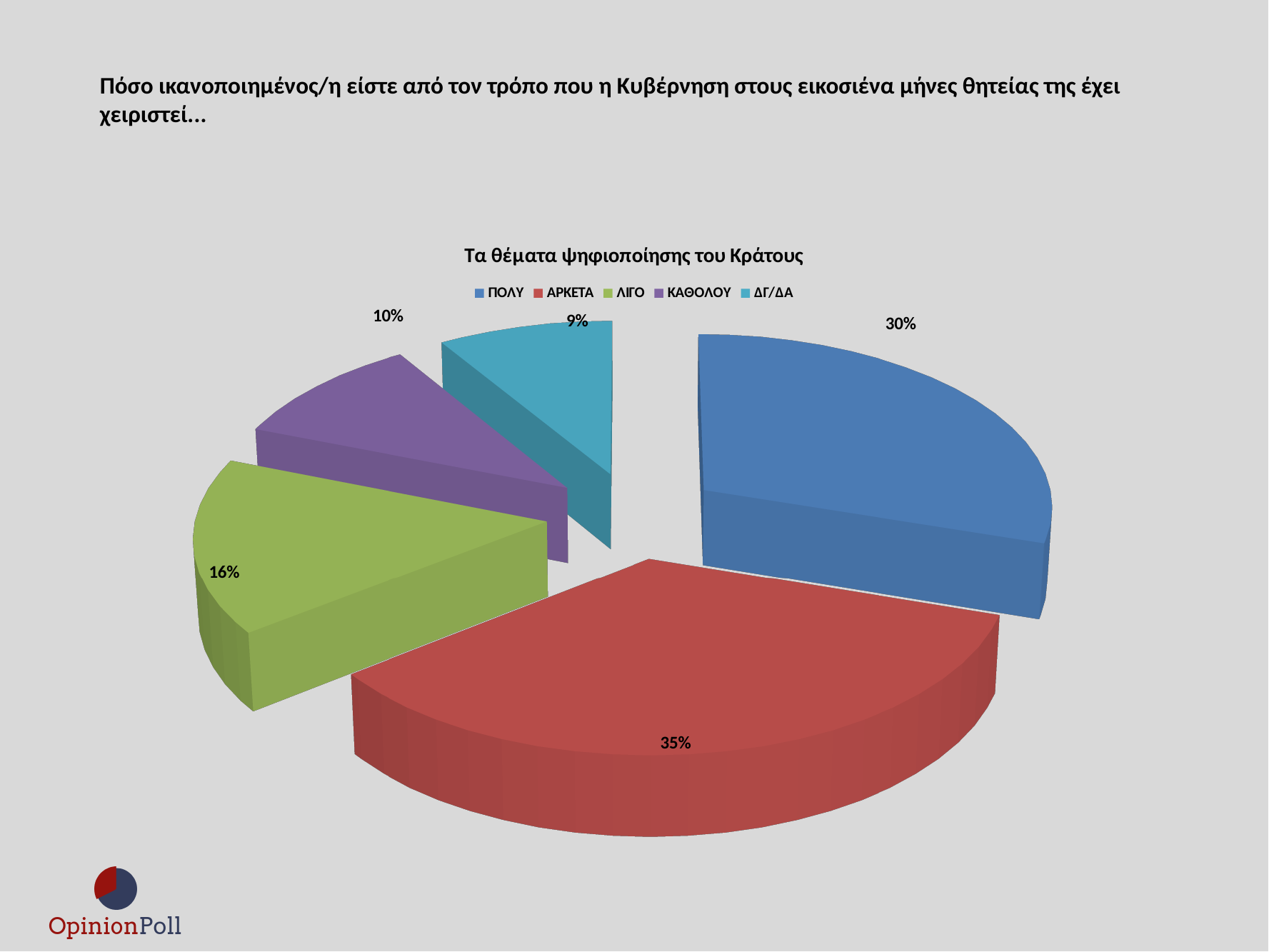
How many categories does the legend of the pie chart list? 5 What is the value for ΑΡΚΕΤΑ in the pie chart? 35% Which is larger, the value for ΛΙΓΟ or the value for ΚΑΘΟΛΟΥ? ΛΙΓΟ What is the value for ΠΟΛΥ in the pie chart? 30% What is the difference between the values for ΑΡΚΕΤΑ and ΠΟΛΥ? 5% What is the title of the pie chart? Τα θέματα ψηφιοποίησης του Κράτους Which category has the largest share of the pie? ΑΡΚΕΤΑ What is the value for ΚΑΘΟΛΟΥ in the pie chart? 10% What is the value for ΔΓ/ΔΑ in the pie chart? 9% Which category has the smallest share of the pie? ΔΓ/ΔΑ What is the value for ΛΙΓΟ in the pie chart? 16% What kind of chart is shown on the slide? Pie chart